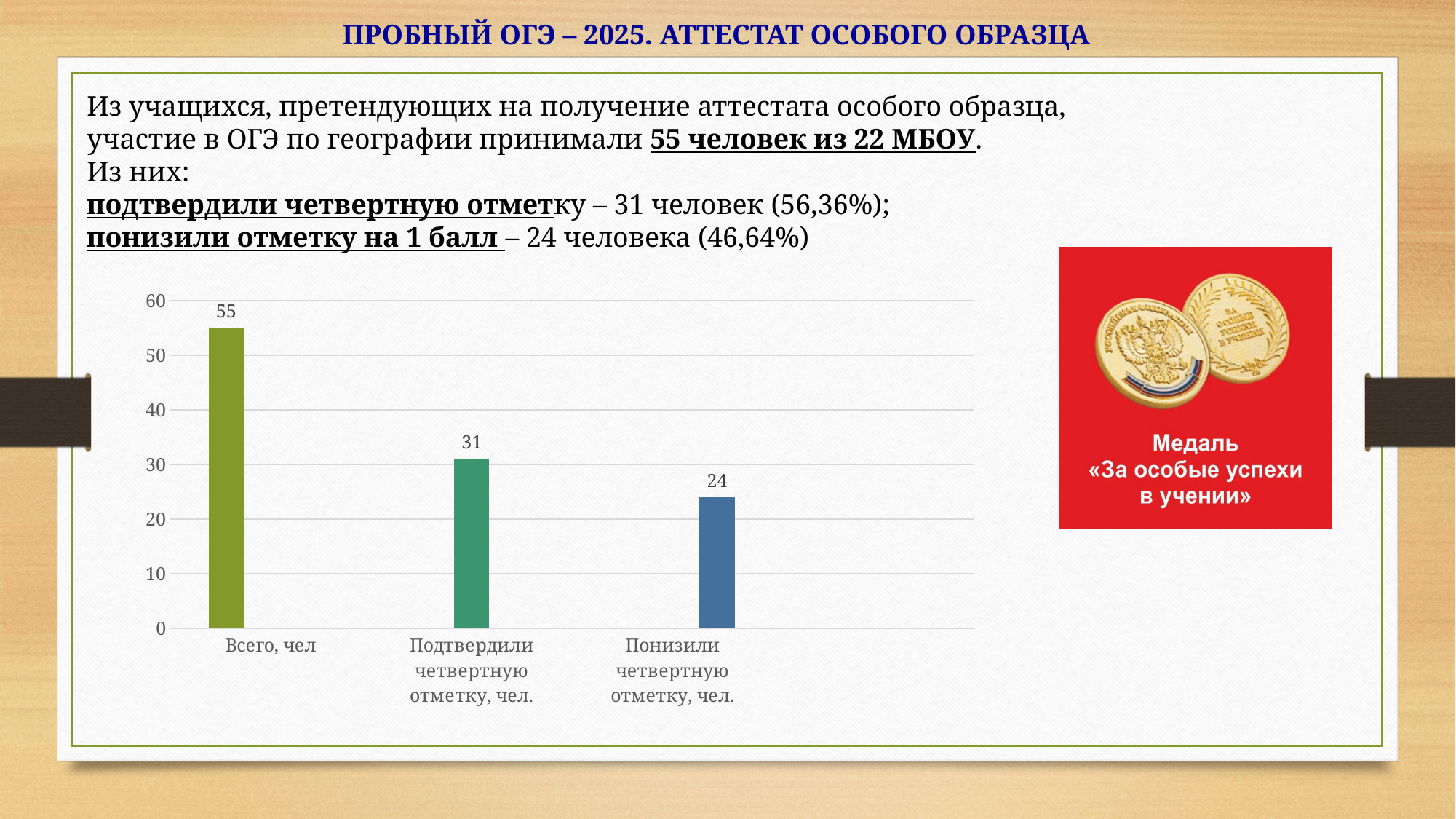
Which category has the highest value? Всего, чел What is the value for "Подтвердили четвертную отметку, чел."? 31 What is the value for "Всего, чел"? 55 What is the value for "Понизили четвертную отметку, чел."? 24 What kind of chart is shown on the slide? bar chart Which is larger: the value for "Подтвердили четвертную отметку, чел." or "Понизили четвертную отметку, чел."? Подтвердили четвертную отметку, чел. Do the values rise or fall from left to right along the x axis? fall Is the value for "Понизили четвертную отметку, чел." greater or less than 30? less Which category has the lowest value? Понизили четвертную отметку, чел. What is the difference between the values for "Подтвердили четвертную отметку, чел." and "Понизили четвертную отметку, чел."? 7 How many categories are shown in the chart? 3 What is the difference between the values for "Всего, чел" and "Подтвердили четвертную отметку, чел."? 24